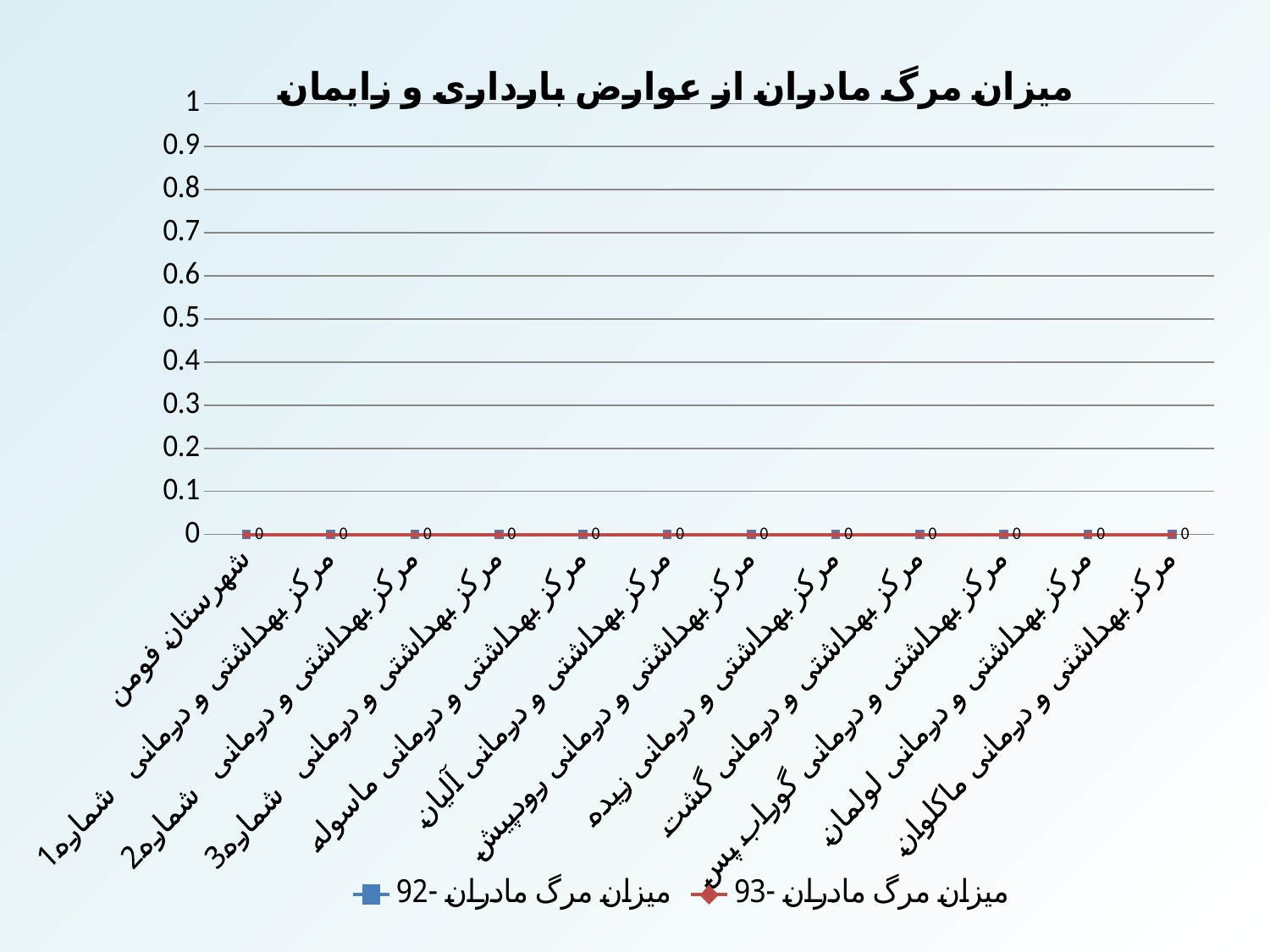
How many series does the legend list? 2 What is the highest value shown on the y axis? 1 What is the value for مرکز بهداشتی و درمانی ماکلوان in the series میزان مرگ مادران -92? 0 What is the difference between the values for مرکز بهداشتی و درمانی گشت and مرکز بهداشتی و درمانی لولمان in the series میزان مرگ مادران -93? 0 What is the value for مرکز بهداشتی و درمانی ماسوله in the series میزان مرگ مادران -93? 0 Do the values of the series میزان مرگ مادران -93 rise, fall, or stay flat along the x axis? stay flat What is the title of the chart? میزان مرگ مادران از عوارض بارداری و زایمان What kind of chart is shown on the slide? line chart Which series is shown with red diamond markers? میزان مرگ مادران -93 What is the value for شهرستان فومن in the series میزان مرگ مادران -92? 0 Is the value for مرکز بهداشتی و درمانی آلیان in the series میزان مرگ مادران -92 greater or less than 0.5? less How many categories are plotted along the x axis? 12